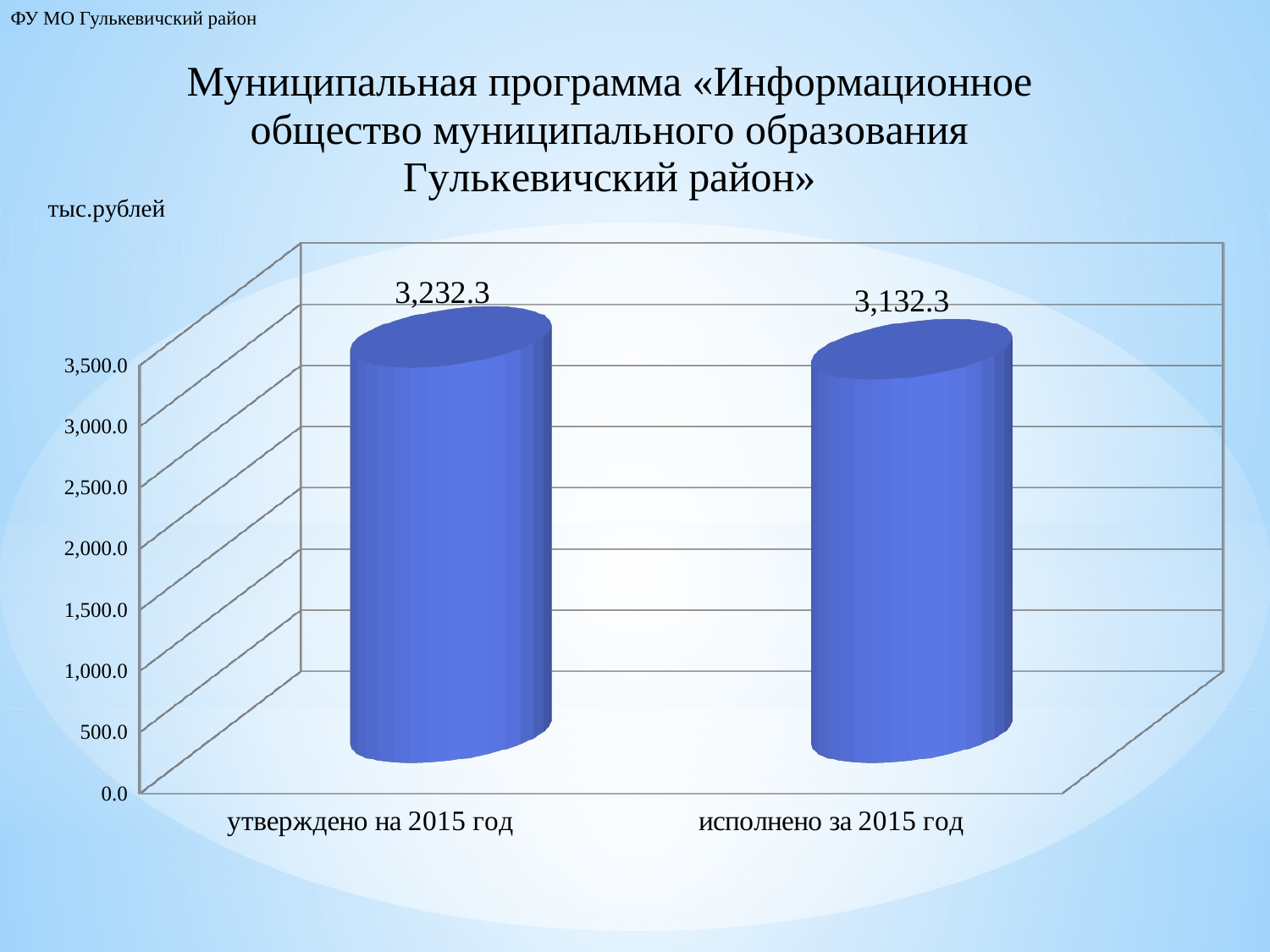
Is the value for «исполнено за 2015 год» greater or less than 3,000.0? greater What is the difference between the value for «утверждено на 2015 год» and the value for «исполнено за 2015 год»? 100.0 Which category has the lowest value? исполнено за 2015 год Do the values rise or fall from the left category to the right category? fall In what units are the values on the chart expressed? тыс.рублей How many categories are shown on the chart? 2 Which category has the highest value? утверждено на 2015 год Is the value for «утверждено на 2015 год» greater or less than 3,500.0? less Which is larger: the value for «утверждено на 2015 год» or the value for «исполнено за 2015 год»? утверждено на 2015 год What kind of chart is shown on the slide? bar chart What is the value for «утверждено на 2015 год»? 3,232.3 What is the value for «исполнено за 2015 год»? 3,132.3